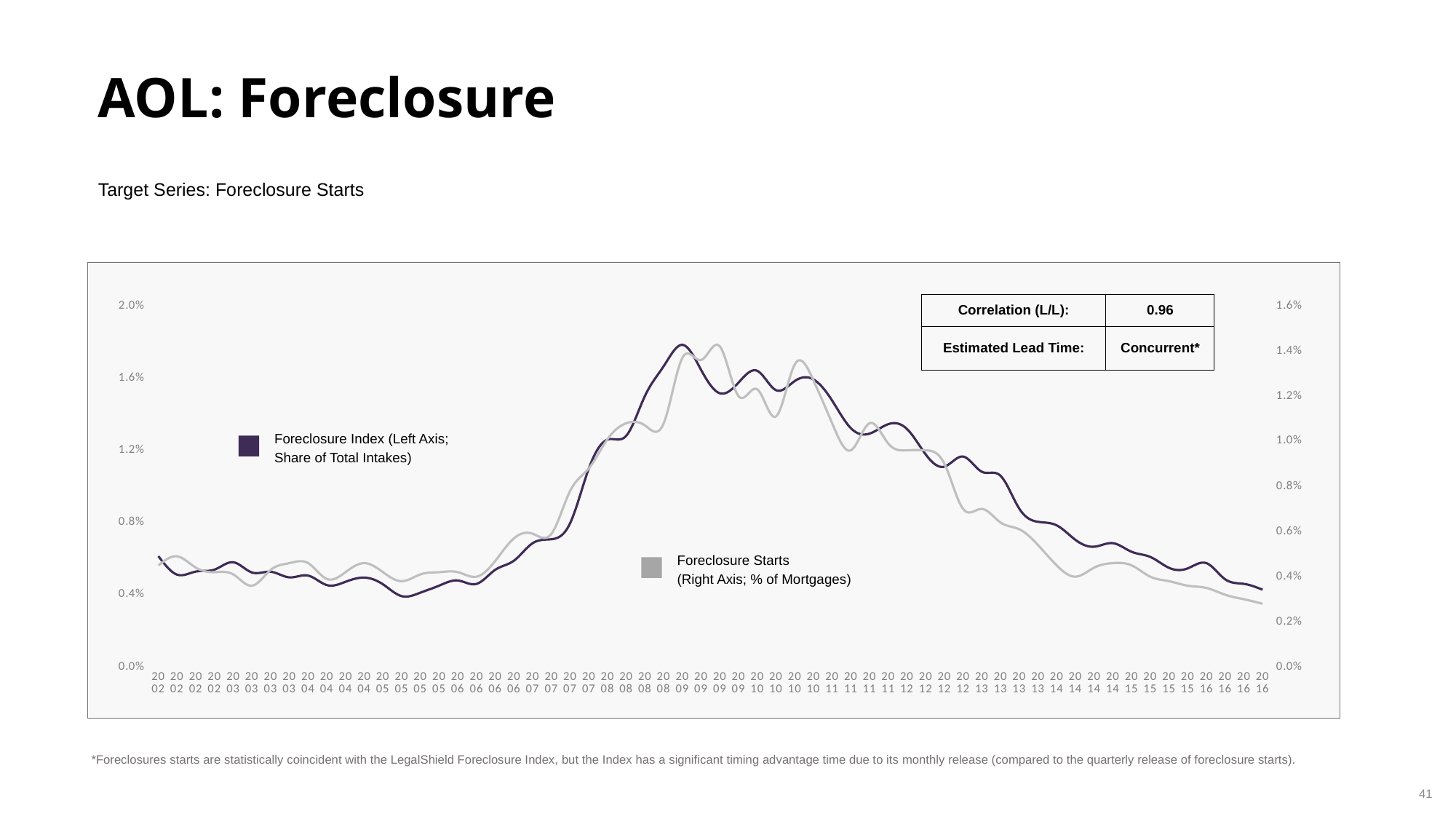
How many series does the chart's legend list? 2 What is the highest tick value shown on the left axis? 2.0% Does the Foreclosure Index rise or fall between 2006 and 2009? rise Is the Foreclosure Starts value at the end of 2016 (right axis) greater or less than 0.4%? less What kind of chart is shown on the slide? Line chart Is the peak value of Foreclosure Starts (right axis) greater or less than 1.2%? greater Is the Foreclosure Index value at the start of 2002 (left axis) greater or less than 0.8%? less What correlation (L/L) value is shown in the table on the chart? 0.96 Which series is plotted against the left axis? Foreclosure Index (Share of Total Intakes) Does the Foreclosure Index rise or fall between 2012 and 2016? fall Does the Foreclosure Starts series rise or fall between 2010 and 2016? fall